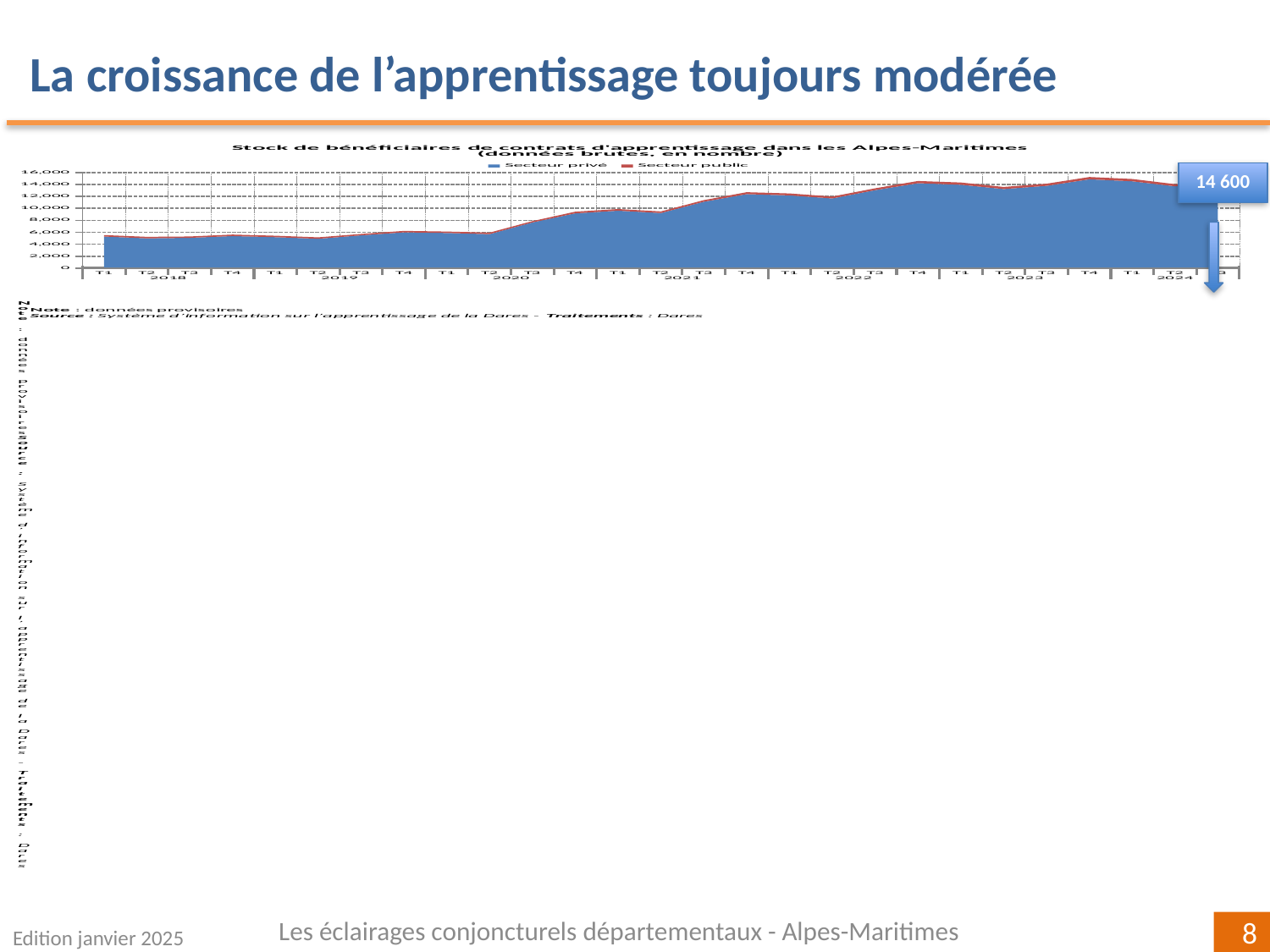
What kind of chart is shown on the slide? area chart Which is larger, the total for T3 2024 or the total for T1 2018? T3 2024 How many series does the chart legend list? 2 Which colour represents the Secteur privé series in the chart? blue Is the total value for T1 2018 greater or less than 8,000? less What value does the callout on the chart give for the most recent quarter (T3 2024)? 14 600 What are the two series named in the chart legend? Secteur privé and Secteur public Is the total value for T3 2024 greater or less than 14,000? greater How many years are labelled on the x axis of the chart? 7 Overall, does the stock of apprenticeship beneficiaries rise or fall from 2018 to 2024? rise Is the total value for T1 2019 greater or less than 8,000? less